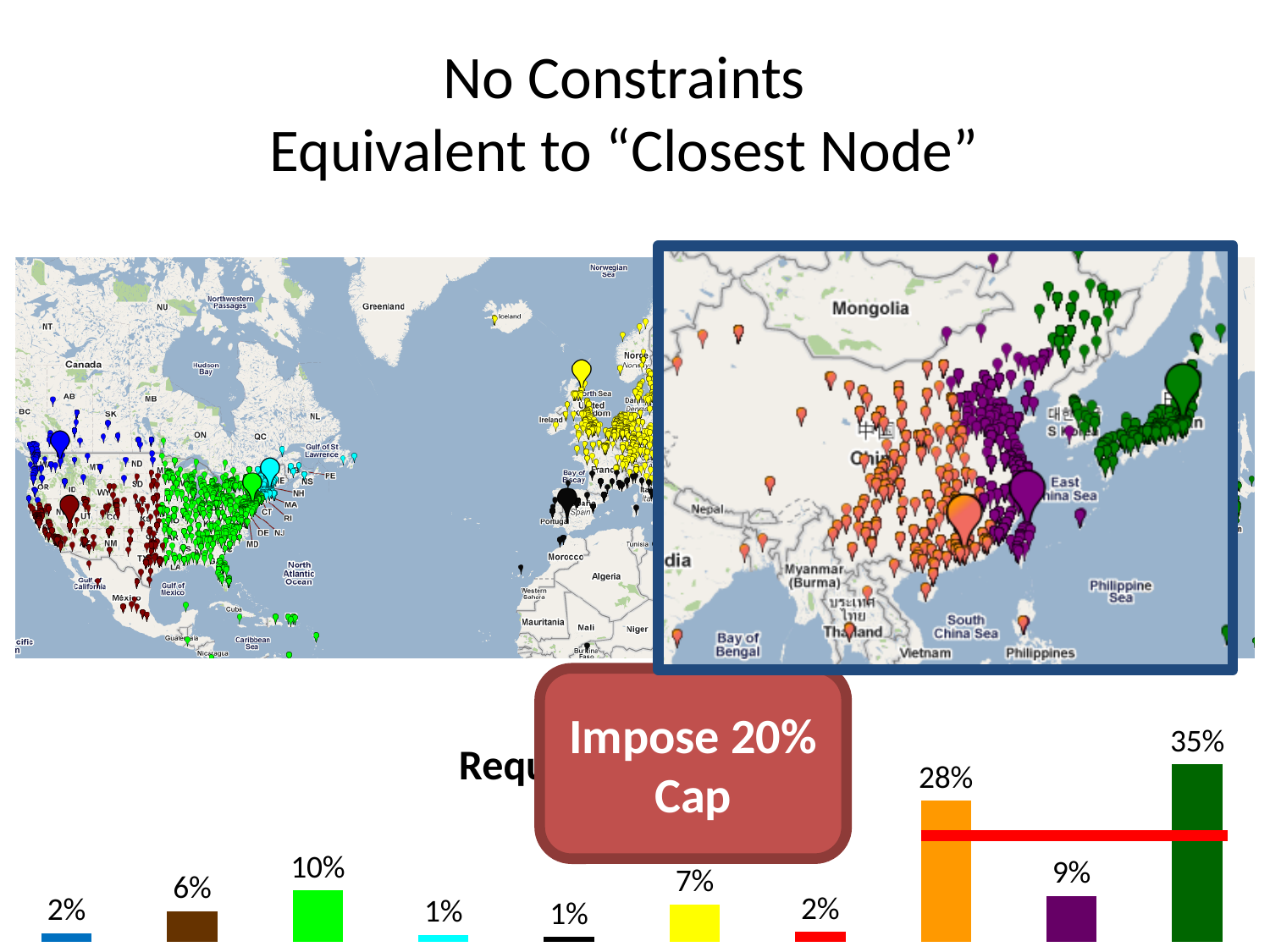
Which bar has the highest value in the bar chart? the dark green bar (35%) What kind of chart is shown at the bottom of the slide? bar chart What is the value of the purple bar in the bar chart? 9% What is the lowest value shown in the bar chart? 1% What is the value of the yellow bar in the bar chart? 7% How many bars are in the bar chart at the bottom of the slide? 10 What cap percentage does the red horizontal line across the bar chart represent, according to the callout box? 20% What is the difference between the dark green bar (35%) and the orange bar (28%)? 7% What is the value of the orange bar in the bar chart? 28% Which is larger in the bar chart, the orange bar or the purple bar? the orange bar What is the value of the bright green bar in the bar chart? 10% What is the value of the dark green bar at the far right of the bar chart? 35%